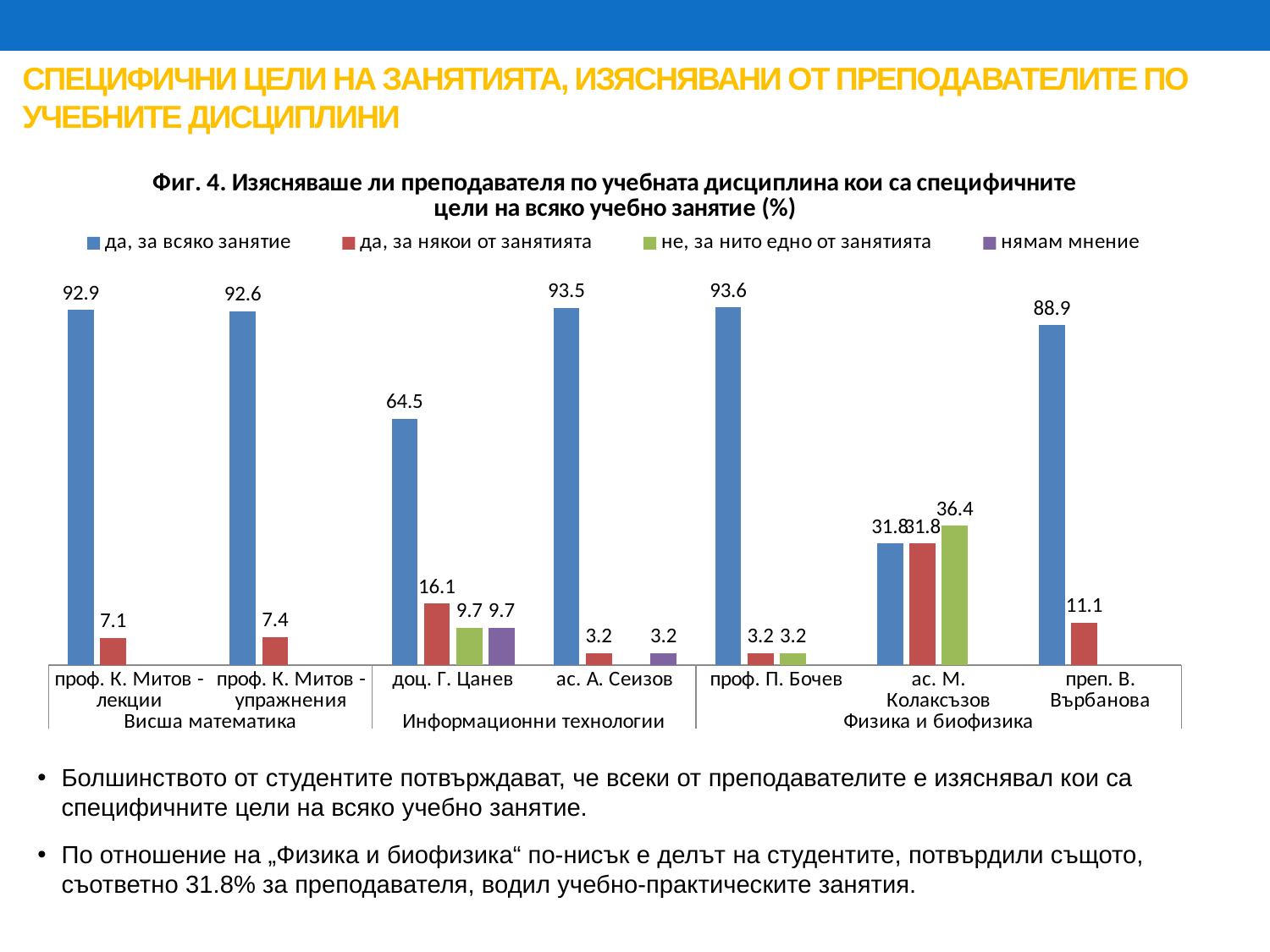
How many series does the legend list? 4 Which is larger for "да, за всяко занятие": доц. Г. Цанев or преп. В. Върбанова? преп. В. Върбанова Which instructor has the lowest value for "да, за всяко занятие"? ас. М. Колаксъзов What type of chart is shown on the slide? bar chart What is the value of "да, за някои от занятията" for преп. В. Върбанова? 11.1 How many instructor categories are shown along the x axis? 7 What is the value of "да, за всяко занятие" for проф. П. Бочев? 93.6 What is the value of "не, за нито едно от занятията" for ас. М. Колаксъзов? 36.4 What is the value of "да, за всяко занятие" for доц. Г. Цанев? 64.5 What is the difference between "да, за всяко занятие" and "да, за някои от занятията" for проф. К. Митов - лекции? 85.8 Which discipline group does ас. А. Сеизов belong to on the x axis? Информационни технологии Which instructor has the highest value for "да, за някои от занятията"? ас. М. Колаксъзов